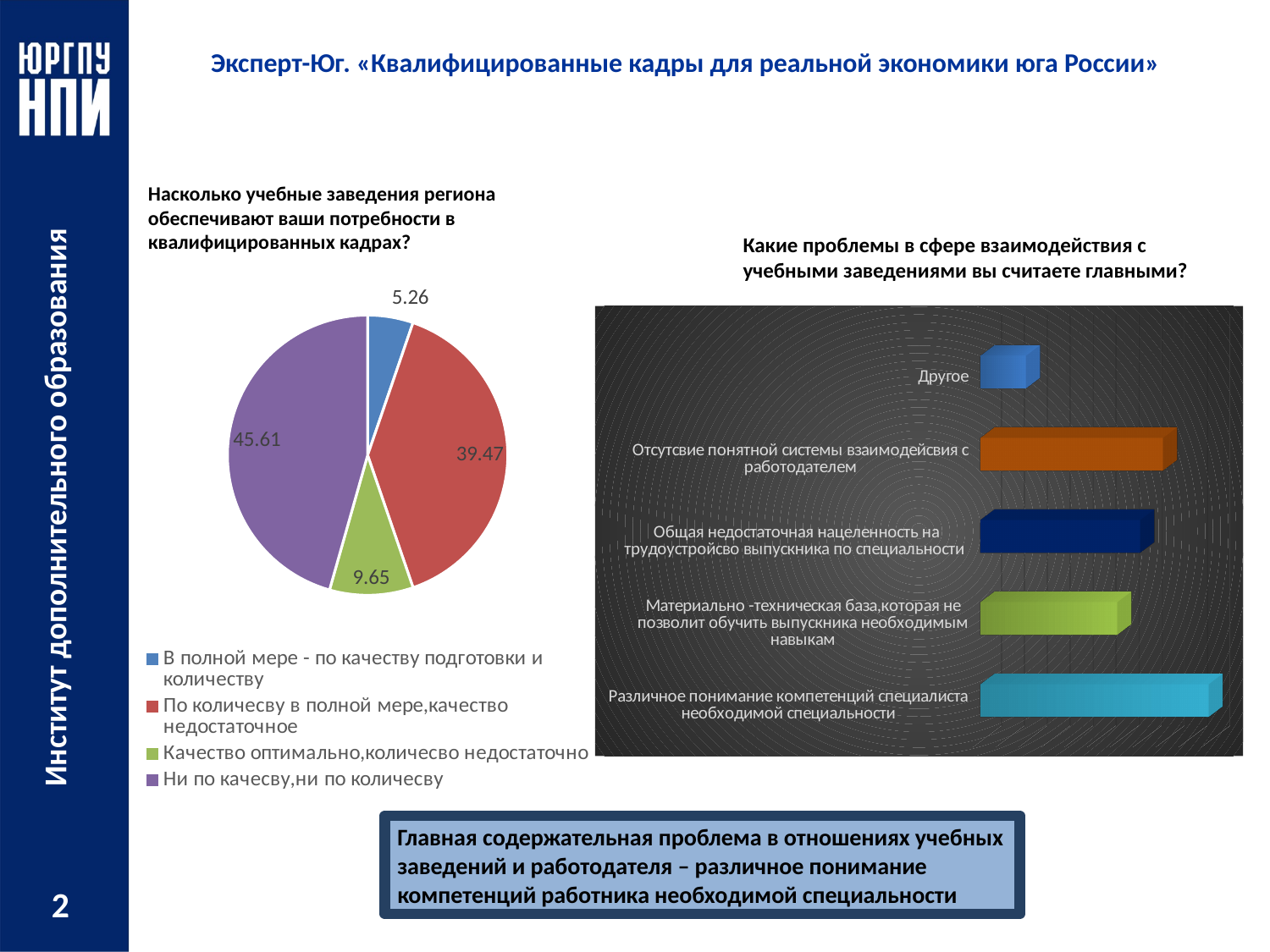
On the pie chart on the left, which is larger: the value for 'Качество оптимально,количесво недостаточно' or the value for 'В полной мере - по качеству подготовки и количеству'? Качество оптимально,количесво недостаточно On the pie chart on the left, what is the difference between the values for 'Ни по качесву,ни по количесву' and 'По количесву в полной мере,качество недостаточное'? 6.14 On the pie chart on the left, what is the value for the slice 'По количесву в полной мере,качество недостаточное'? 39.47 On the pie chart on the left, what is the value for the slice 'Качество оптимально,количесво недостаточно'? 9.65 On the bar chart on the right, which category has the shortest bar? Другое What type of chart is shown on the right side of the slide? Bar chart On the pie chart on the left, which category has the largest slice? Ни по качесву,ни по количесву On the pie chart on the left, which category has the smallest slice? В полной мере - по качеству подготовки и количеству On the pie chart on the left, what is the value for the slice 'Ни по качесву,ни по количесву'? 45.61 On the bar chart on the right, which category has the longest bar? Различное понимание компетенций специалиста необходимой специальности How many categories are shown on the bar chart on the right? 5 How many slices does the pie chart on the left have? 4